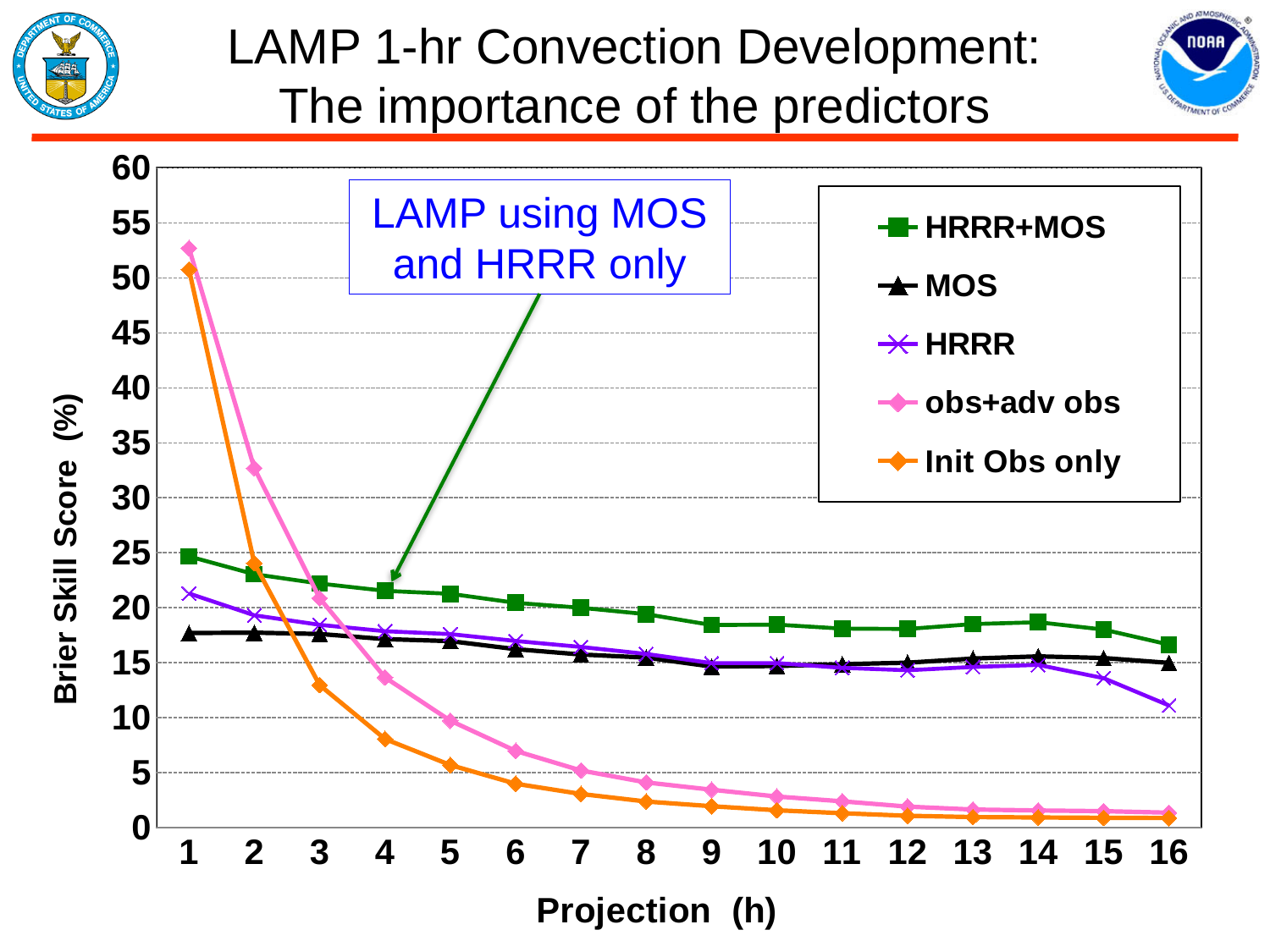
Which series has the lowest Brier Skill Score at projection 4? Init Obs only Is the value for Init Obs only at projection 2 greater or less than 20? greater At projection 16, which is larger: HRRR or MOS? MOS What kind of chart is shown on the slide? line chart Which series has the highest Brier Skill Score at projection 16? HRRR+MOS How many projection hours are plotted along the x axis? 16 What is the label of the y axis? Brier Skill Score (%) Does the obs+adv obs series rise or fall as the projection hour increases? fall How many series does the legend list? 5 Is the value for HRRR+MOS at projection 1 greater or less than 20? greater At projection 1, which is larger: HRRR or MOS? HRRR Is the value for obs+adv obs at projection 6 greater or less than 10? less